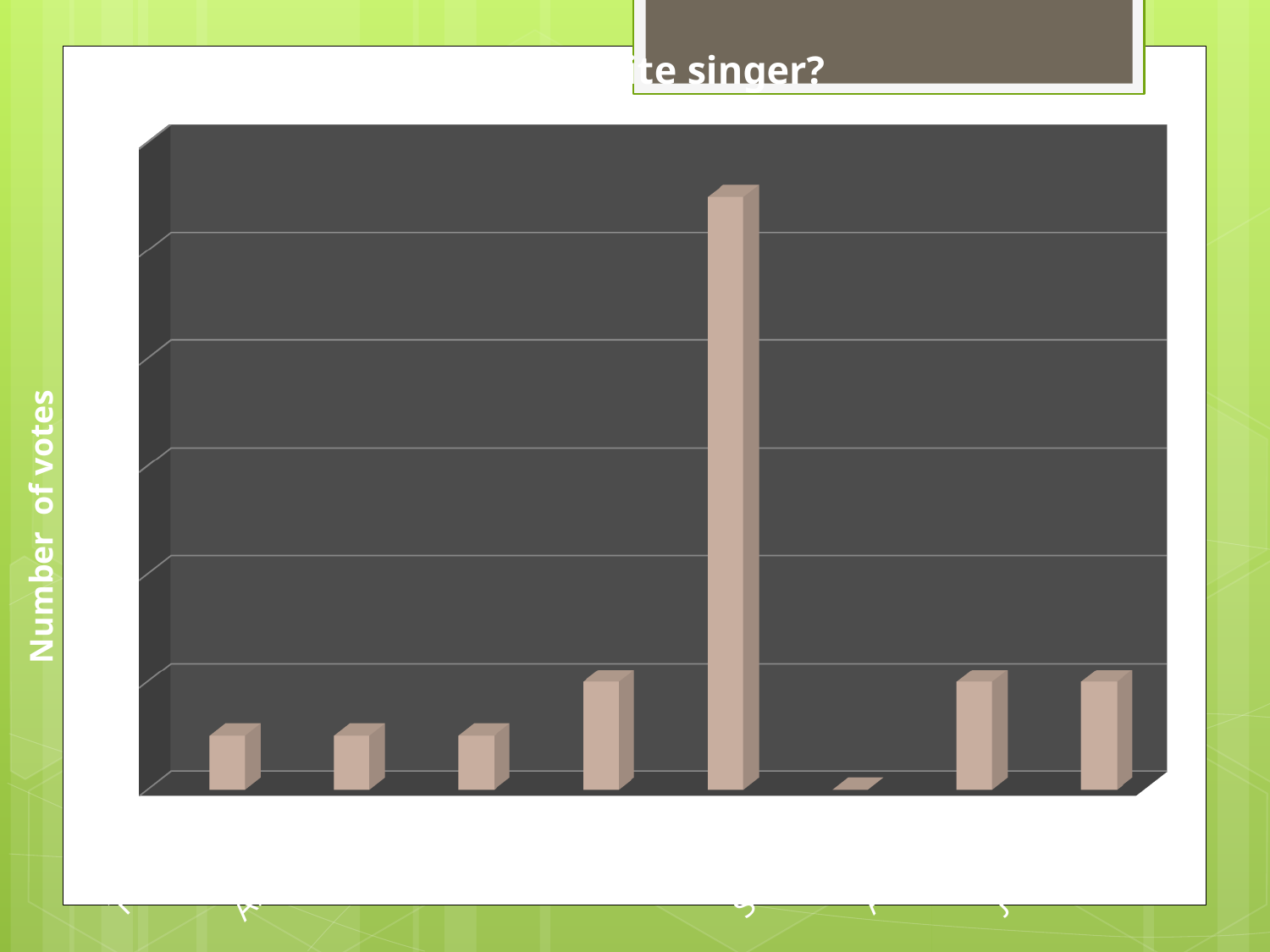
Is the first bar from the left taller or shorter than the seventh bar from the left? shorter How many bars are plotted in the chart? 8 Which bar, counted from the left, is the shortest in the chart? the sixth bar What is the label on the vertical axis of the chart? Number of votes What colour are the bars in the chart? tan (light brown) Is the fifth bar from the left taller or shorter than the fourth bar from the left? taller What kind of chart is shown on the slide? bar chart Which bar, counted from the left, is the tallest in the chart? the fifth bar